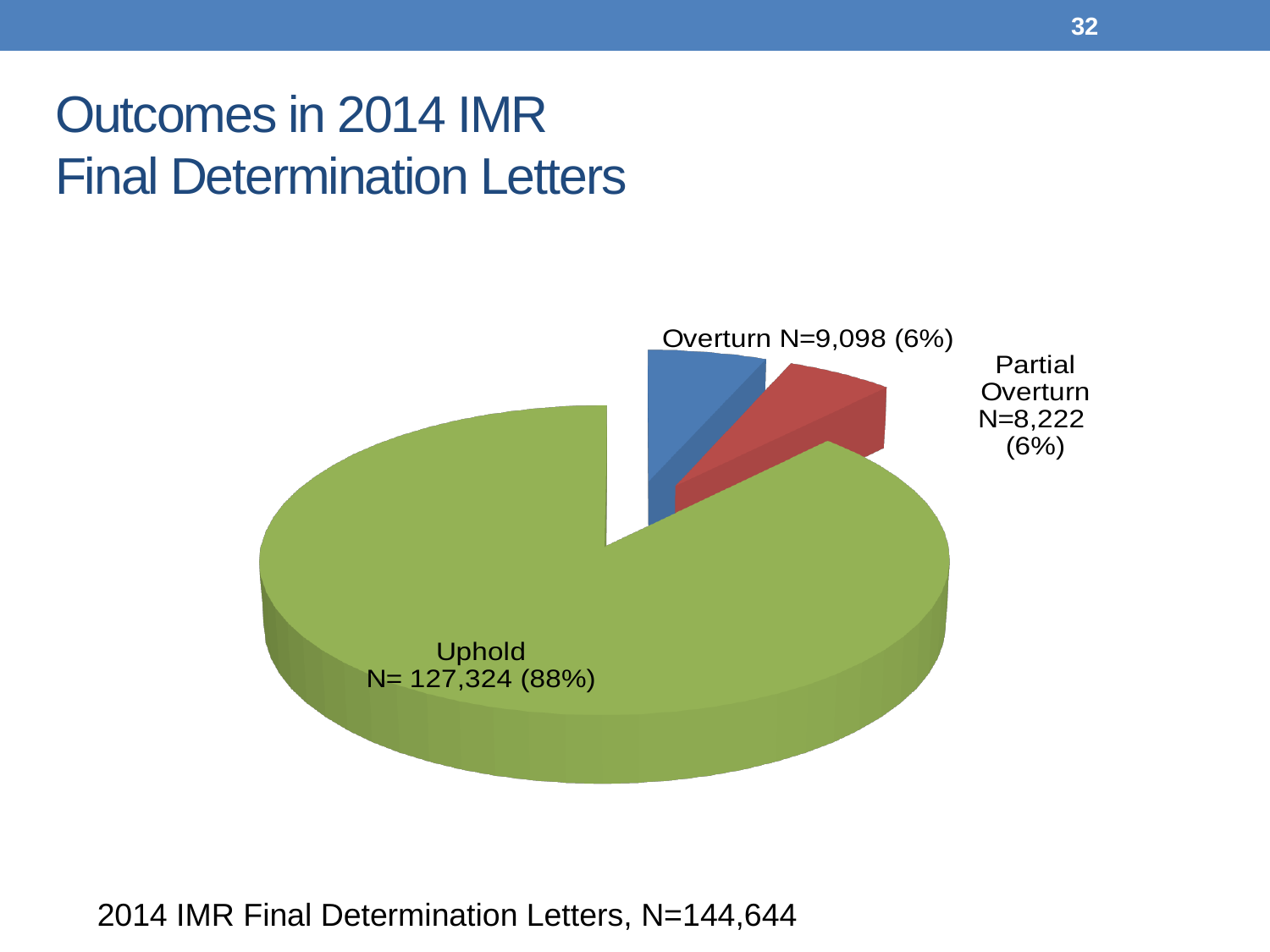
What colour is the Uphold slice of the pie? Green What is the difference in N between Overturn and Partial Overturn? 876 What is the N value for the Partial Overturn slice? 8,222 Which has a larger N value, Overturn or Partial Overturn? Overturn Which outcome has the smallest N value? Partial Overturn What is the N value for the Overturn slice? 9,098 What percentage share of the pie does Uphold represent? 88% Which outcome has the largest slice of the pie? Uphold What type of chart is shown on the slide? Pie chart What is the N value for the Uphold slice? 127,324 What percentage share of the pie does Partial Overturn represent? 6% How many slices does the pie chart have? 3